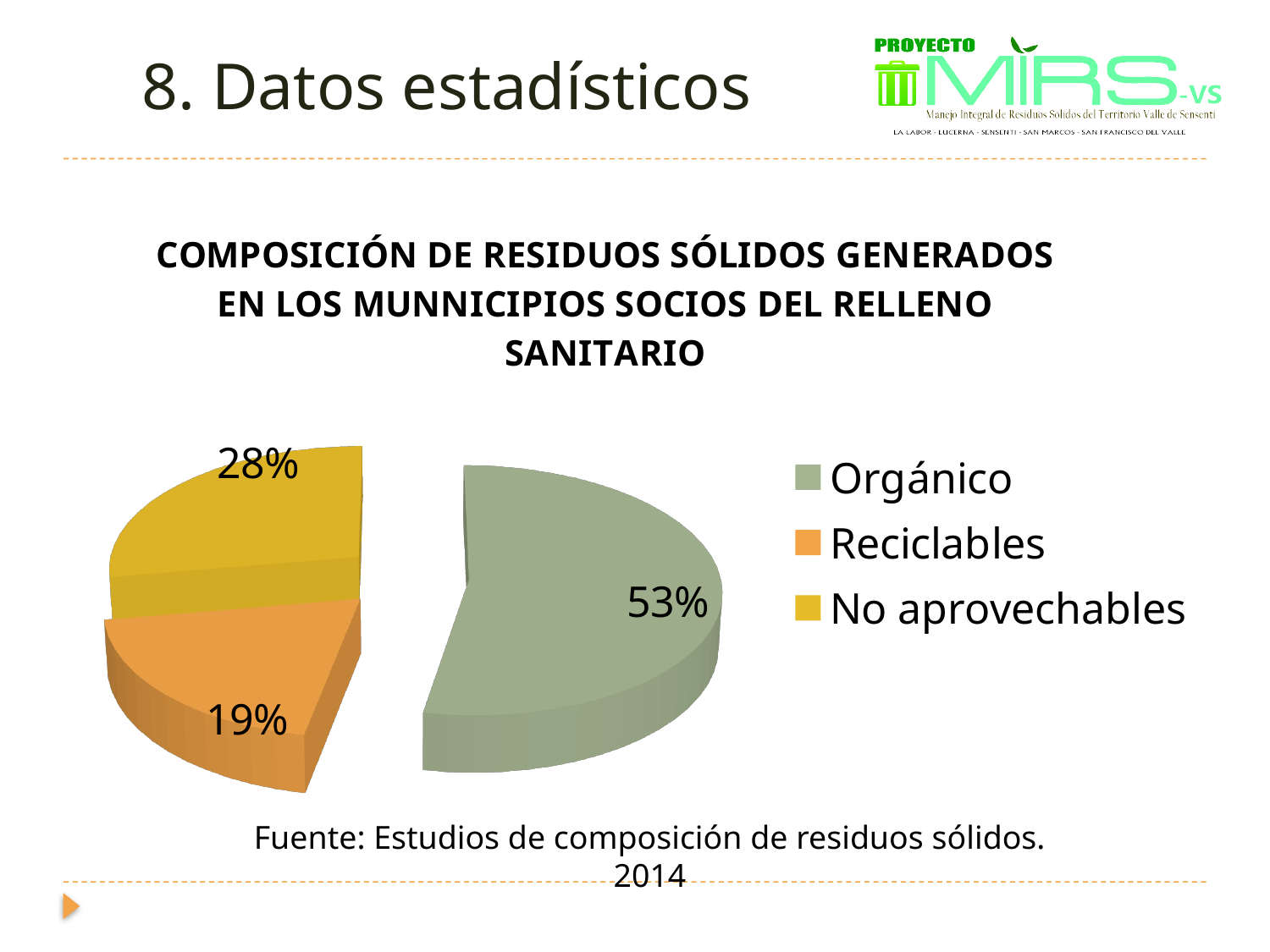
What share of the pie does Reciclables represent? 19% What colour is the Orgánico slice in the pie chart? Green What kind of chart is shown on the slide? Pie chart What is the difference in percentage points between No aprovechables and Reciclables? 9 What is the difference in percentage points between Orgánico and No aprovechables? 25 Which category has the largest share of the pie? Orgánico Which is larger, the share for Reciclables or the share for No aprovechables? No aprovechables What share of the pie does No aprovechables represent? 28% How many categories are shown in the pie chart? 3 Which category has the smallest share of the pie? Reciclables What source is cited below the chart? Estudios de composición de residuos sólidos. 2014 What share of the pie does Orgánico represent? 53%